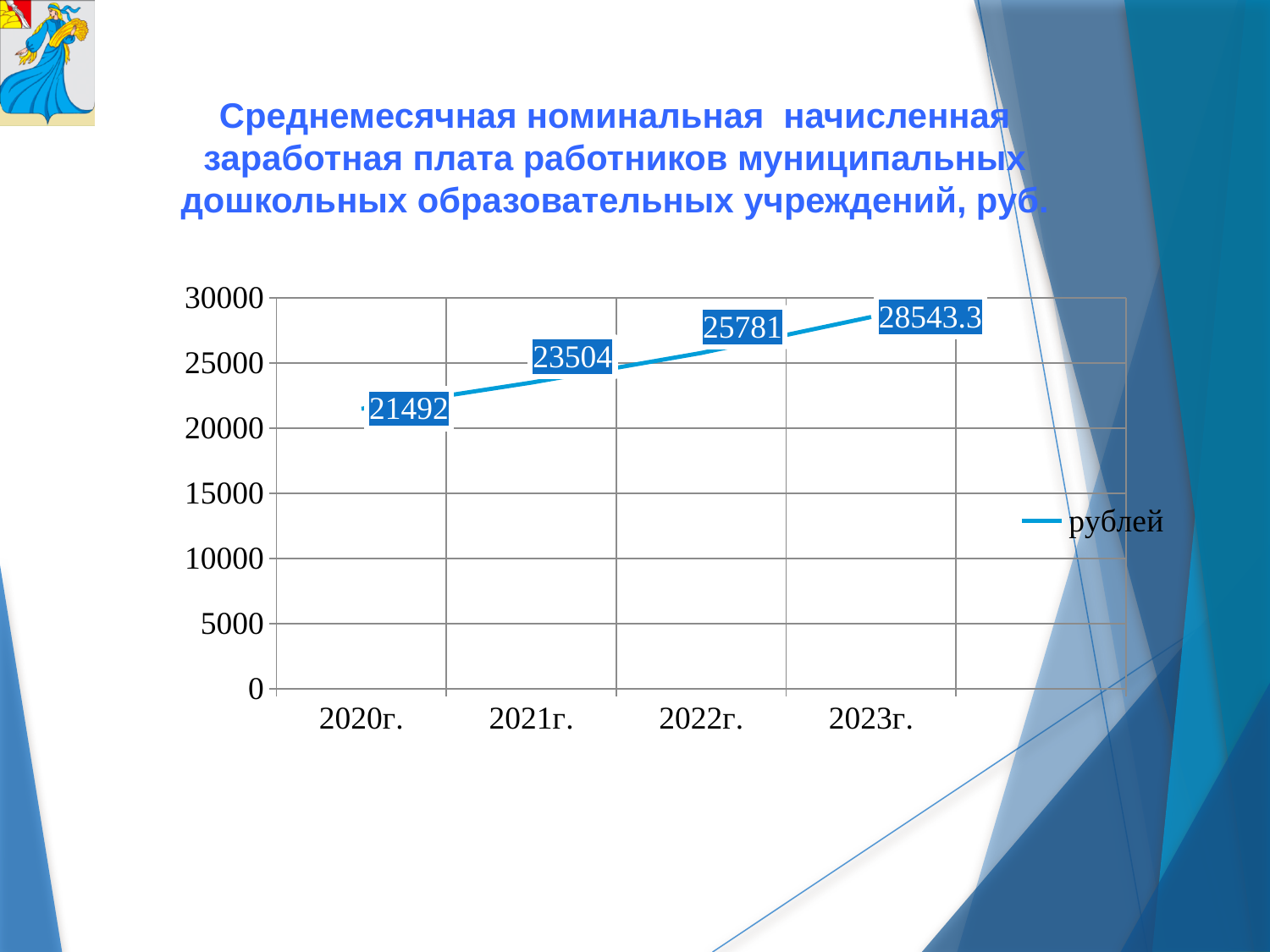
What is the value for 2021г.? 23504 What is the value for 2020г.? 21492 Which is larger, the value for 2022г. or the value for 2021г.? 2022г. Which year has the highest value? 2023г. How many years are plotted on the chart? 4 Which year has the lowest value? 2020г. Do the values rise or fall from 2020г. to 2023г.? rise What is the value for 2023г.? 28543.3 What is the difference between the values for 2021г. and 2020г.? 2012 What is the value for 2022г.? 25781 What is the difference between the values for 2022г. and 2021г.? 2277 What kind of chart is shown on the slide? line chart